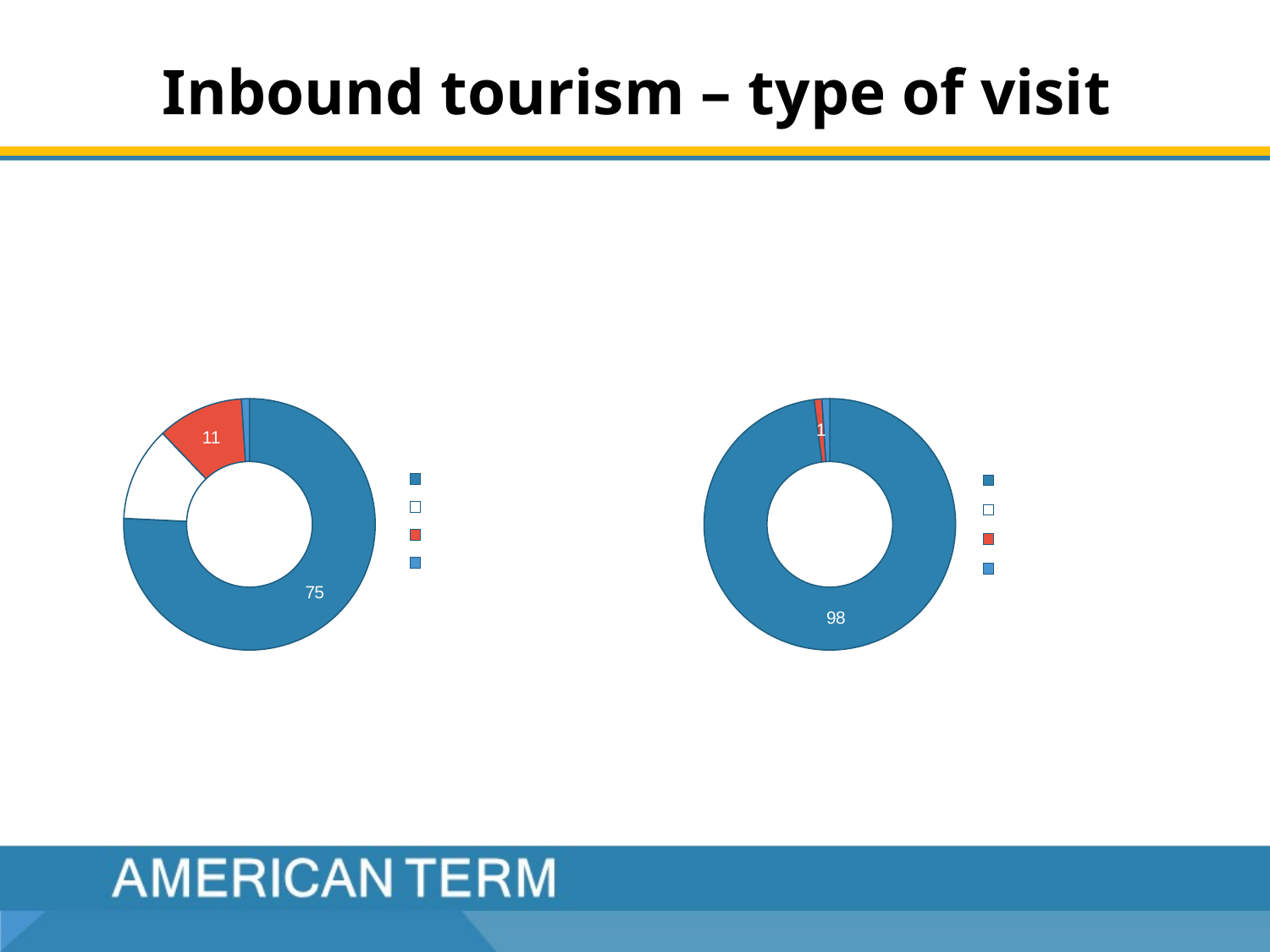
In the left chart, what is the difference between the blue slice labelled 75 and the red slice labelled 11? 64 In the left chart, which is larger, the blue slice or the red slice? the blue slice In the left chart, what value is labelled on the large blue slice? 75 In the right chart, which colour slice is the largest? blue In the right chart, what is the difference between the blue slice labelled 98 and the red slice labelled 1? 97 In the right chart, what value is labelled on the red slice? 1 How many charts are on the slide? 2 In the left chart, what value is labelled on the red slice? 11 In the right chart, what value is labelled on the large blue slice? 98 How many legend swatches are shown next to each chart? 4 In the left chart, which colour slice is the largest? blue What kind of chart is shown on the left of the slide? doughnut chart